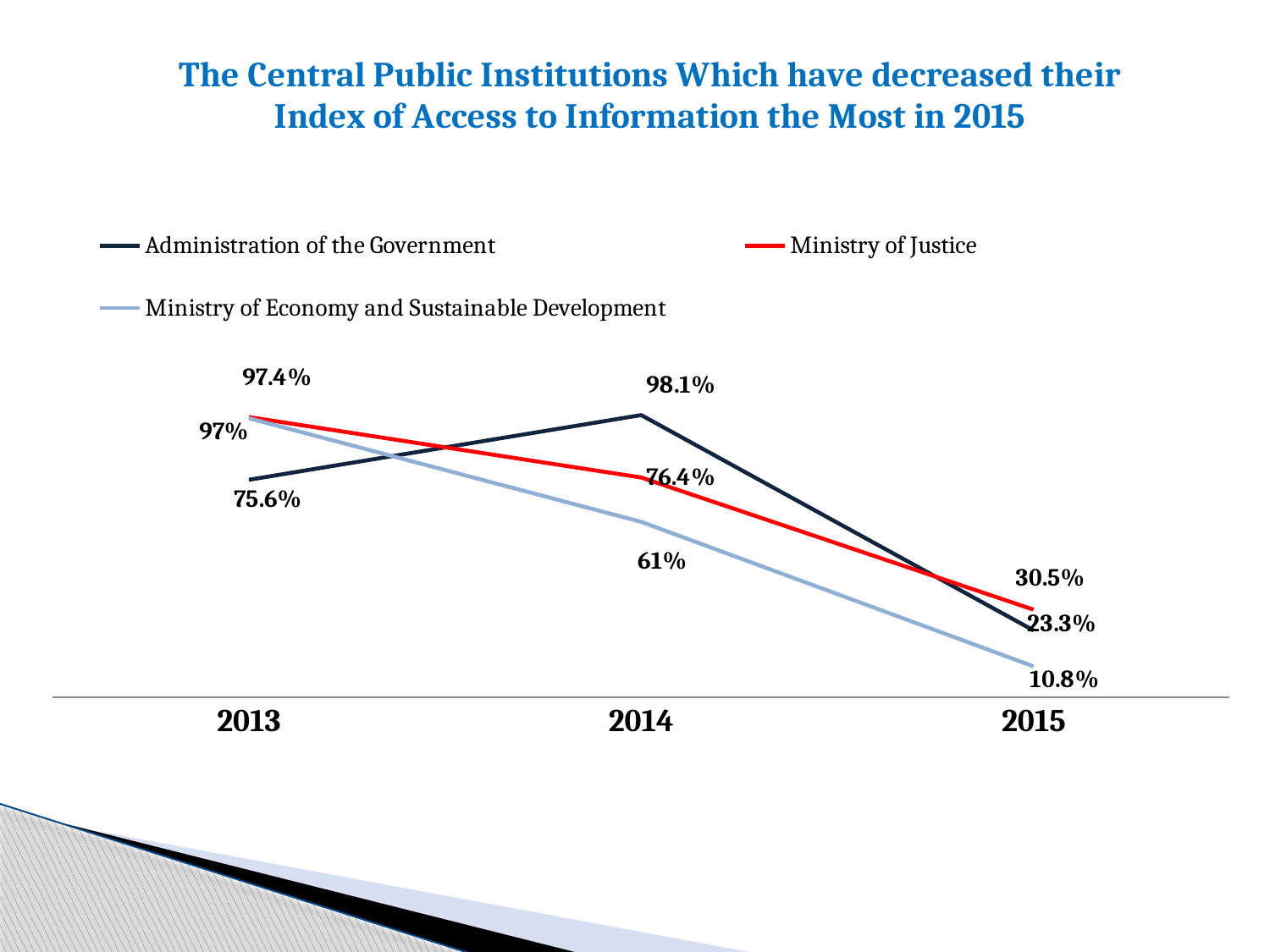
How many series does the legend list? 3 What is the value for Administration of the Government in 2014? 98.1% How many years are shown on the x axis? 3 Which is larger in 2014, the value for Ministry of Justice or for Ministry of Economy and Sustainable Development? Ministry of Justice Which institution has the lowest value in 2015? Ministry of Economy and Sustainable Development What is the value for Ministry of Economy and Sustainable Development in 2015? 10.8% What is the value for Ministry of Economy and Sustainable Development in 2014? 61% What is the value for Ministry of Justice in 2015? 30.5% What kind of chart is shown on the slide? Line chart By how many percentage points did Administration of the Government fall from 2014 to 2015? 74.8 percentage points What is the value for Administration of the Government in 2013? 75.6% Which institution has the highest value in 2015? Ministry of Justice